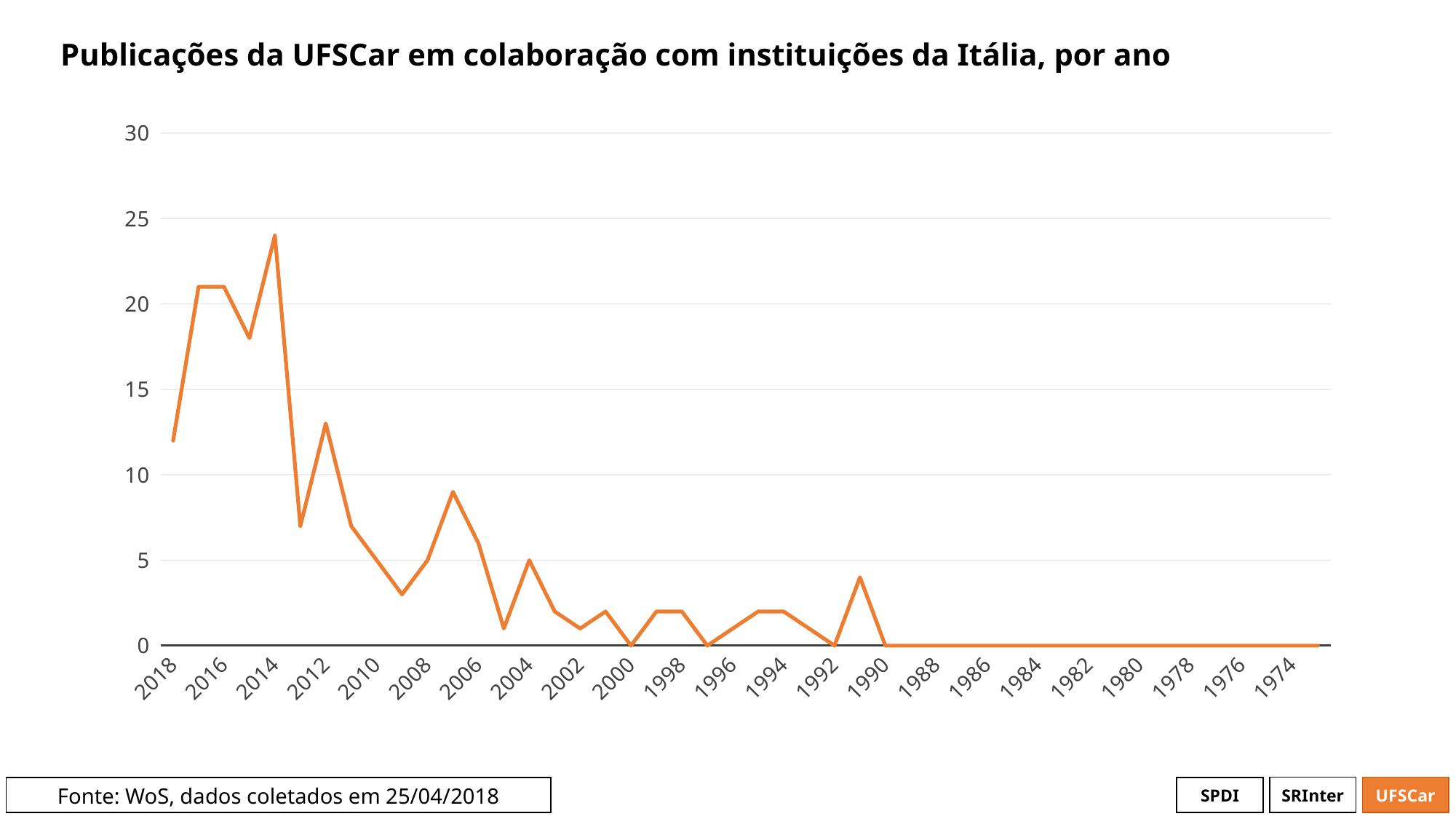
Is the value for 2012 greater or less than 10? greater Which year has the highest number of publications? 2014 Is the value for 2014 greater or less than 20? greater What is the value for 2000? 0 What is the value for 1988? 0 Which year has the larger value, 2016 or 2018? 2016 What is the title of the chart? Publicações da UFSCar em colaboração com instituições da Itália, por ano What kind of chart is shown on the slide? line chart Is the value for 2006 greater or less than 10? less Do the values generally rise or fall moving from 2014 toward 1990 along the x axis? fall Which year has the larger value, 2014 or 2012? 2014